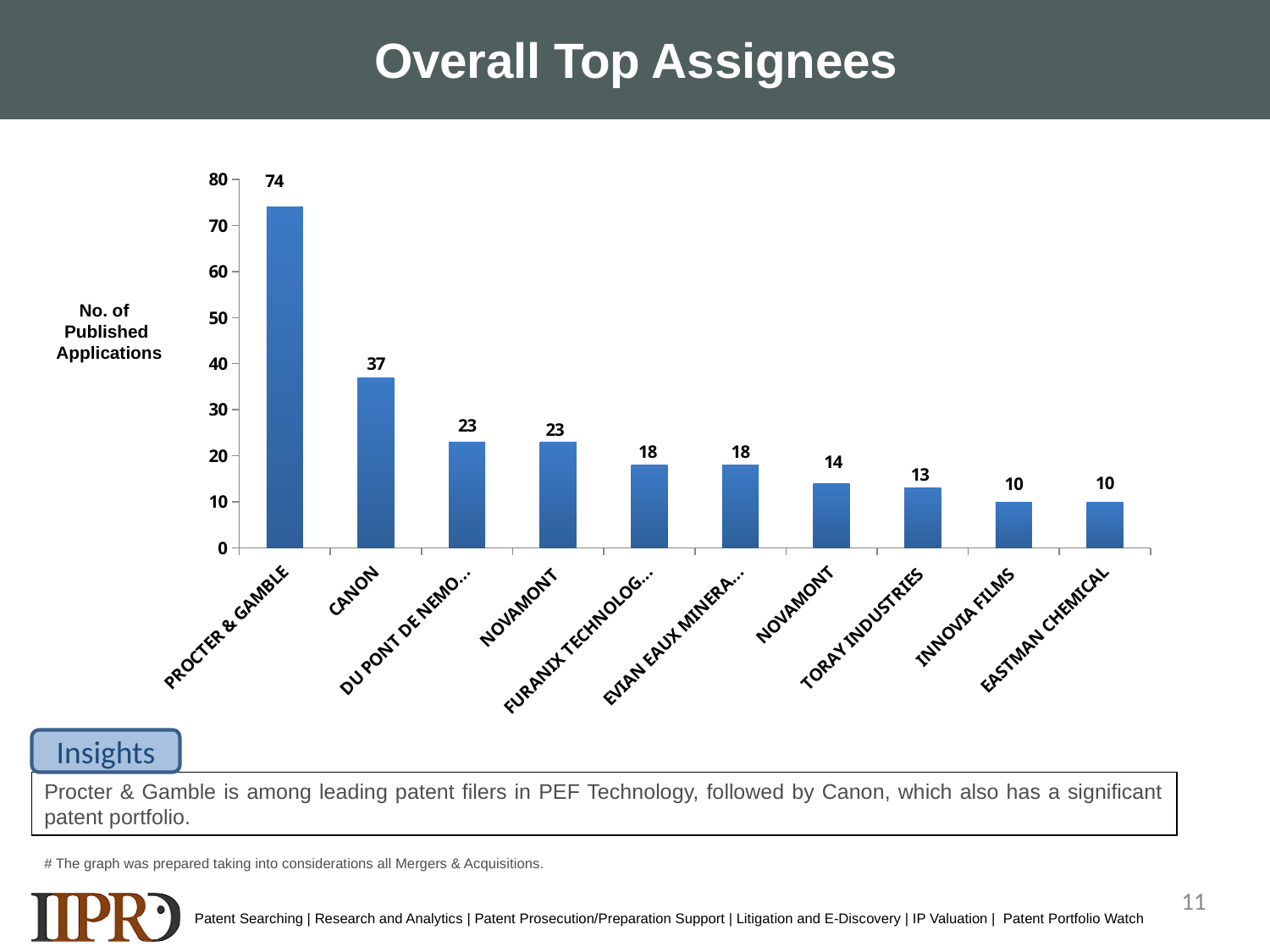
How many assignees are shown in the chart? 10 Which has more published applications, CANON or TORAY INDUSTRIES? CANON What type of chart is shown on the slide? bar chart How many published applications does CANON have? 37 How many published applications does TORAY INDUSTRIES have? 13 Which assignee has the highest number of published applications? PROCTER & GAMBLE What is the title of the chart on the slide? Overall Top Assignees What is the difference in published applications between PROCTER & GAMBLE and CANON? 37 How many published applications does INNOVIA FILMS have? 10 How many published applications does EASTMAN CHEMICAL have? 10 How many published applications does PROCTER & GAMBLE have? 74 Do the values generally rise or fall from left to right across the chart? fall